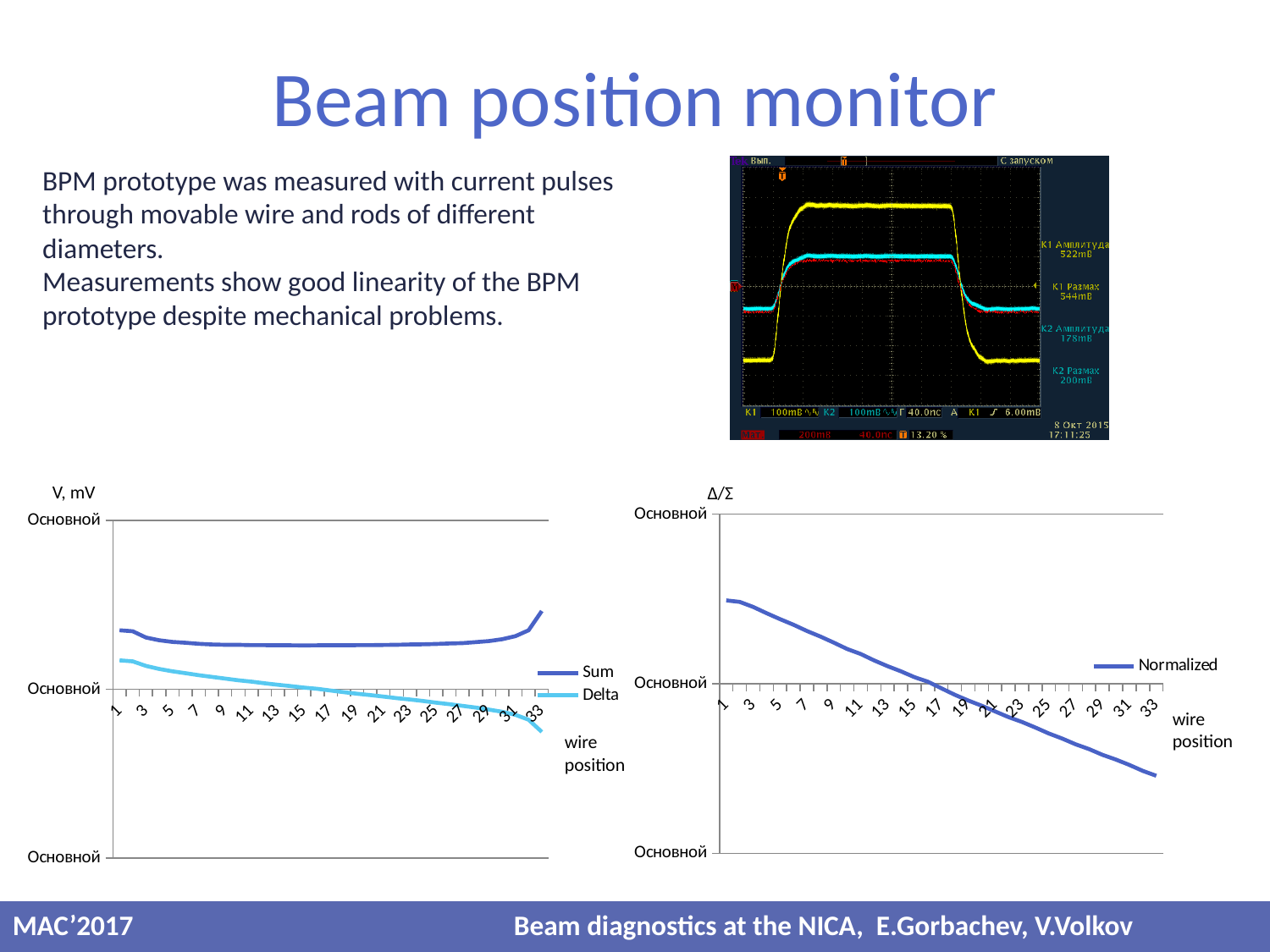
In the left chart (V, mV), which series is higher at wire position 1, Sum or Delta? Sum In the left chart (V, mV), which series is higher at wire position 17, Sum or Delta? Sum What are the legend entries of the left chart (V, mV)? Sum, Delta How many series does the legend of the right chart (Δ/Σ) list? 1 What is the name of the series in the right chart (Δ/Σ)? Normalized What kind of chart is the left chart labelled V, mV? line chart In the right chart (Δ/Σ), does the Normalized series rise or fall as wire position increases? fall In the right chart (Δ/Σ), is the Normalized value at wire position 1 larger or smaller than at wire position 33? larger What kind of chart is the right chart labelled Δ/Σ? line chart In the left chart (V, mV), does the Delta series rise or fall as wire position increases? fall How many series does the legend of the left chart (V, mV) list? 2